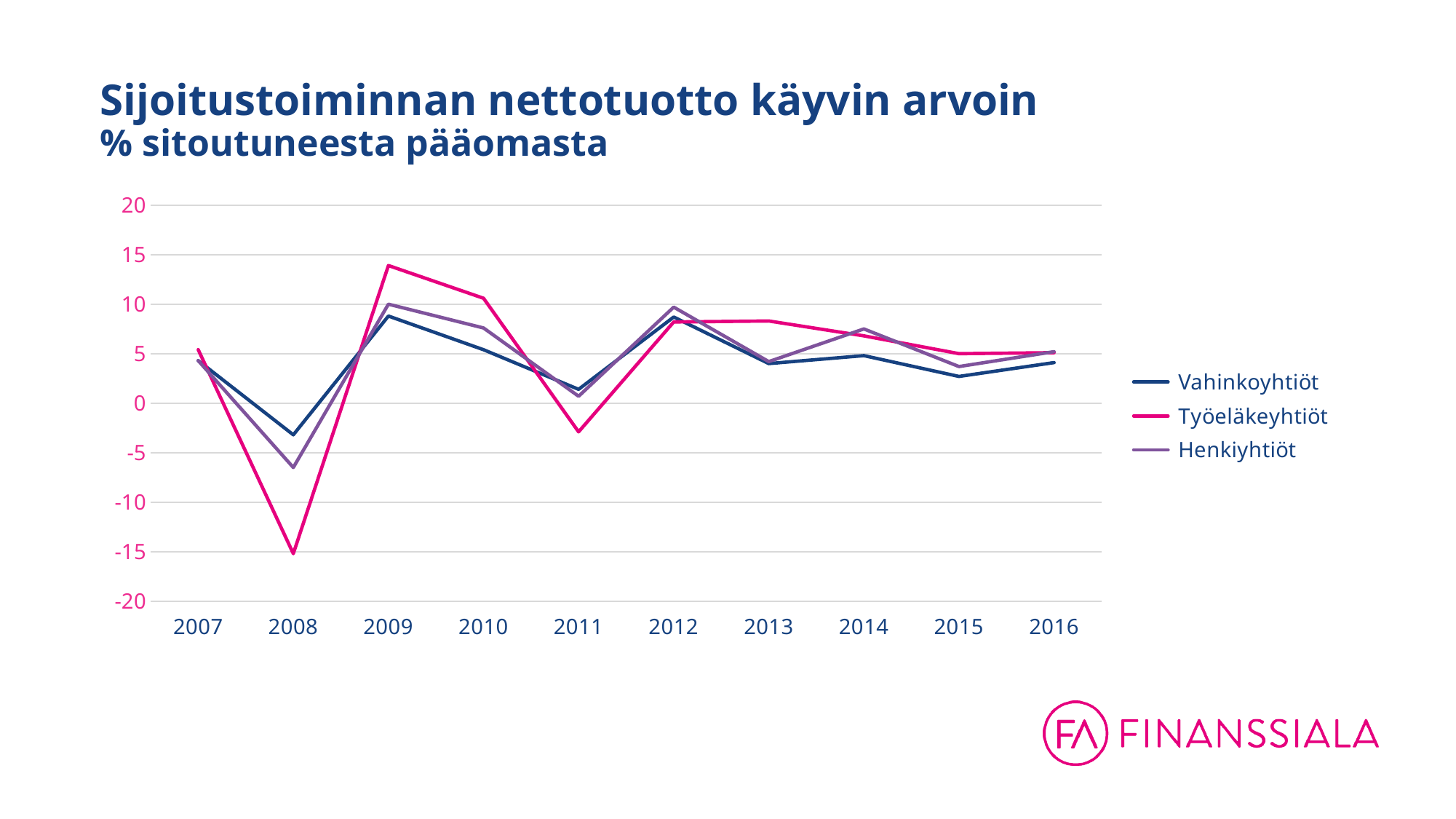
Is the value for Työeläkeyhtiöt in 2008 greater or less than -10? less In 2008, which series has the larger value, Vahinkoyhtiöt or Työeläkeyhtiöt? Vahinkoyhtiöt How many years are shown on the x axis? 10 How many series does the legend list? 3 In which year is the value for Työeläkeyhtiöt highest? 2009 Is the value for Työeläkeyhtiöt in 2009 greater or less than 10? greater In which year is the value for Työeläkeyhtiöt lowest? 2008 In 2011, which series has the larger value, Työeläkeyhtiöt or Henkiyhtiöt? Henkiyhtiöt What kind of chart is shown on the slide? line chart Does the value for Työeläkeyhtiöt rise or fall from 2013 to 2015? fall Is the value for Henkiyhtiöt in 2008 greater or less than 0? less In which year is the value for Vahinkoyhtiöt lowest? 2008